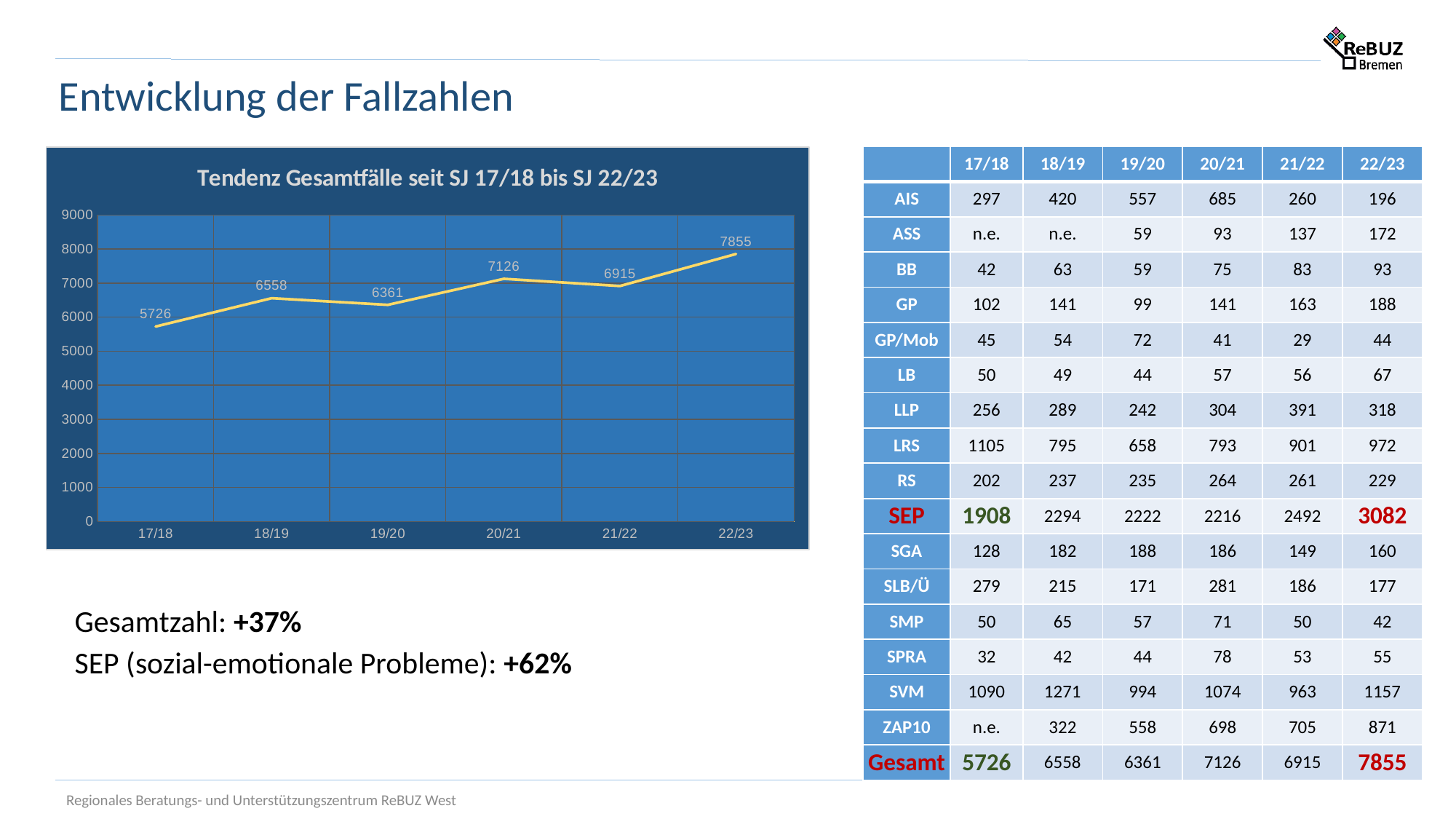
Which is larger in the line chart, the value for 20/21 or the value for 21/22? 20/21 What is the value for 17/18 in the line chart? 5726 What is the title of the line chart? Tendenz Gesamtfälle seit SJ 17/18 bis SJ 22/23 What kind of chart is shown on the slide? line chart What is the value for 19/20 in the line chart? 6361 Which school year has the lowest value in the line chart? 17/18 How many school years are plotted in the line chart? 6 Which school year has the highest value in the line chart? 22/23 What is the value for 22/23 in the line chart? 7855 Is the value for 18/19 in the line chart greater or less than 6000? greater What is the difference between the values for 22/23 and 17/18 in the line chart? 2129 Does the value in the line chart rise or fall from 21/22 to 22/23? rise